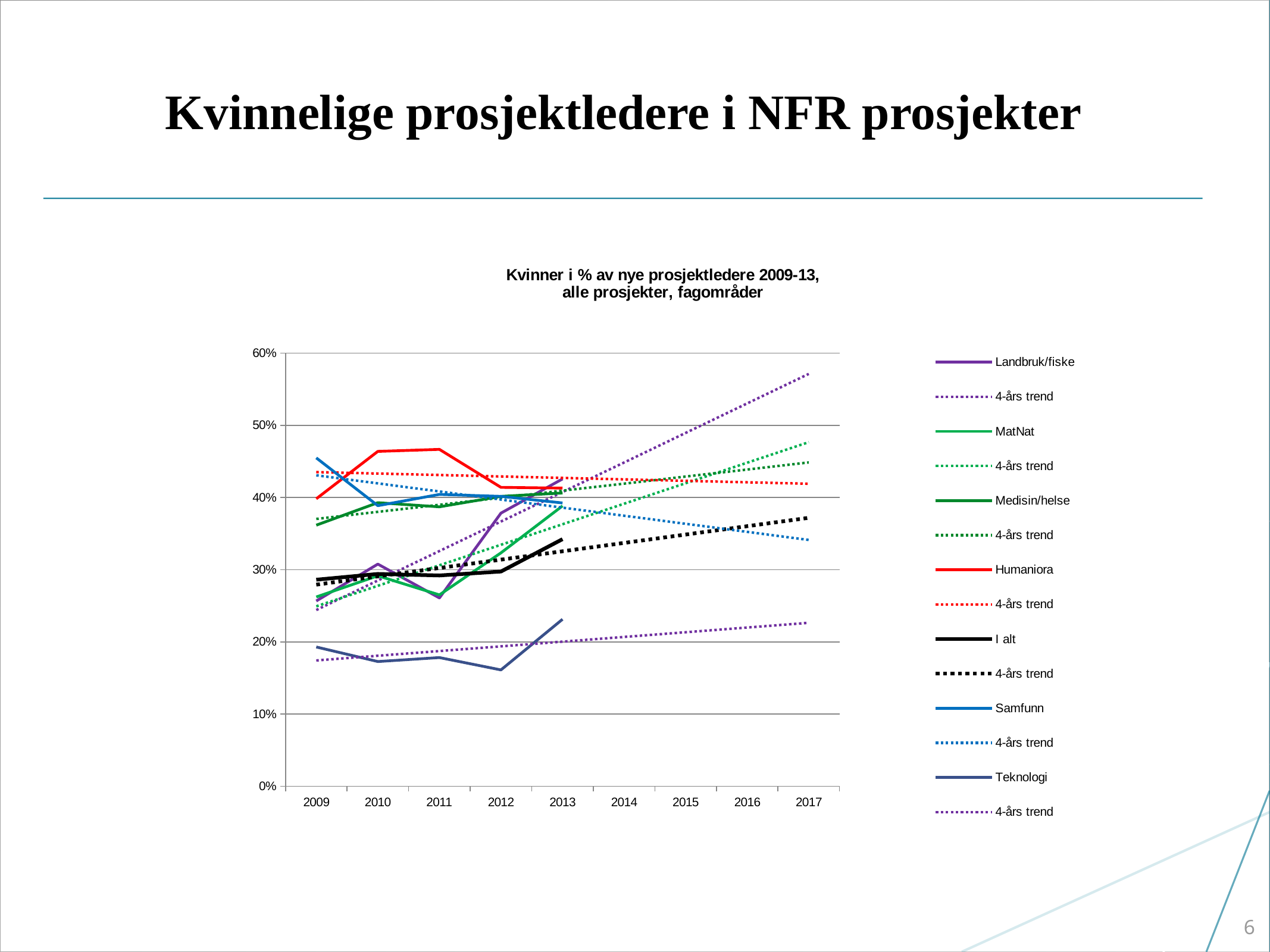
What is the title of the chart? Kvinner i % av nye prosjektledere 2009-13, alle prosjekter, fagområder Is the value for Landbruk/fiske in 2011 greater or less than 30%? less Is the value for Humaniora in 2011 greater or less than 40%? greater How many years are labelled on the x axis? 9 Does the 4-års trend line for Samfunn rise or fall from 2009 to 2017? fall How many entries does the legend list? 14 Is the value for Samfunn in 2009 greater or less than 40%? greater Which series has the lowest value in 2013? Teknologi Which series has the highest value in 2011? Humaniora What kind of chart is shown on the slide? line chart